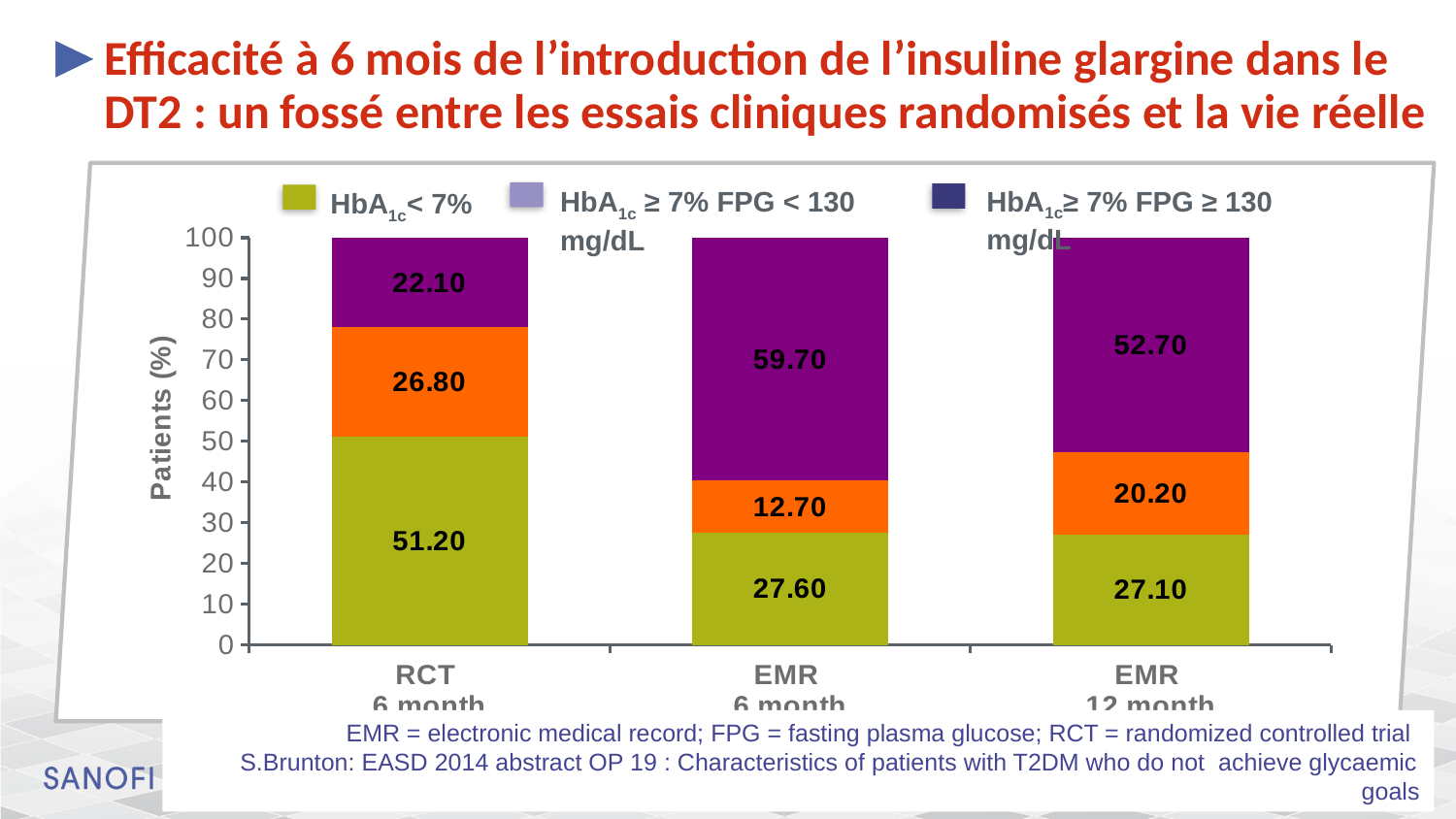
What is the label on the y axis of the chart? Patients (%) What is the value of the top (purple) segment for EMR 12 month? 52.70 Which category has the lowest value for the top (purple) segment? RCT 6 month How many bars (categories) are shown on the x axis of the chart? 3 What is the value of the HbA1c < 7% (bottom, green) segment for EMR 6 month? 27.60 Which is larger: the middle (orange) segment for RCT 6 month or for EMR 12 month? RCT 6 month What is the difference between the top (purple) segment values for EMR 6 month and EMR 12 month? 7.00 Which category has the highest value for the HbA1c < 7% (bottom, green) segment? RCT 6 month What is the value of the HbA1c < 7% (bottom, green) segment for RCT 6 month? 51.20 What type of chart is shown on the slide? Stacked bar chart What is the value of the middle (orange) segment for EMR 6 month? 12.70 How many series does the legend list? 3